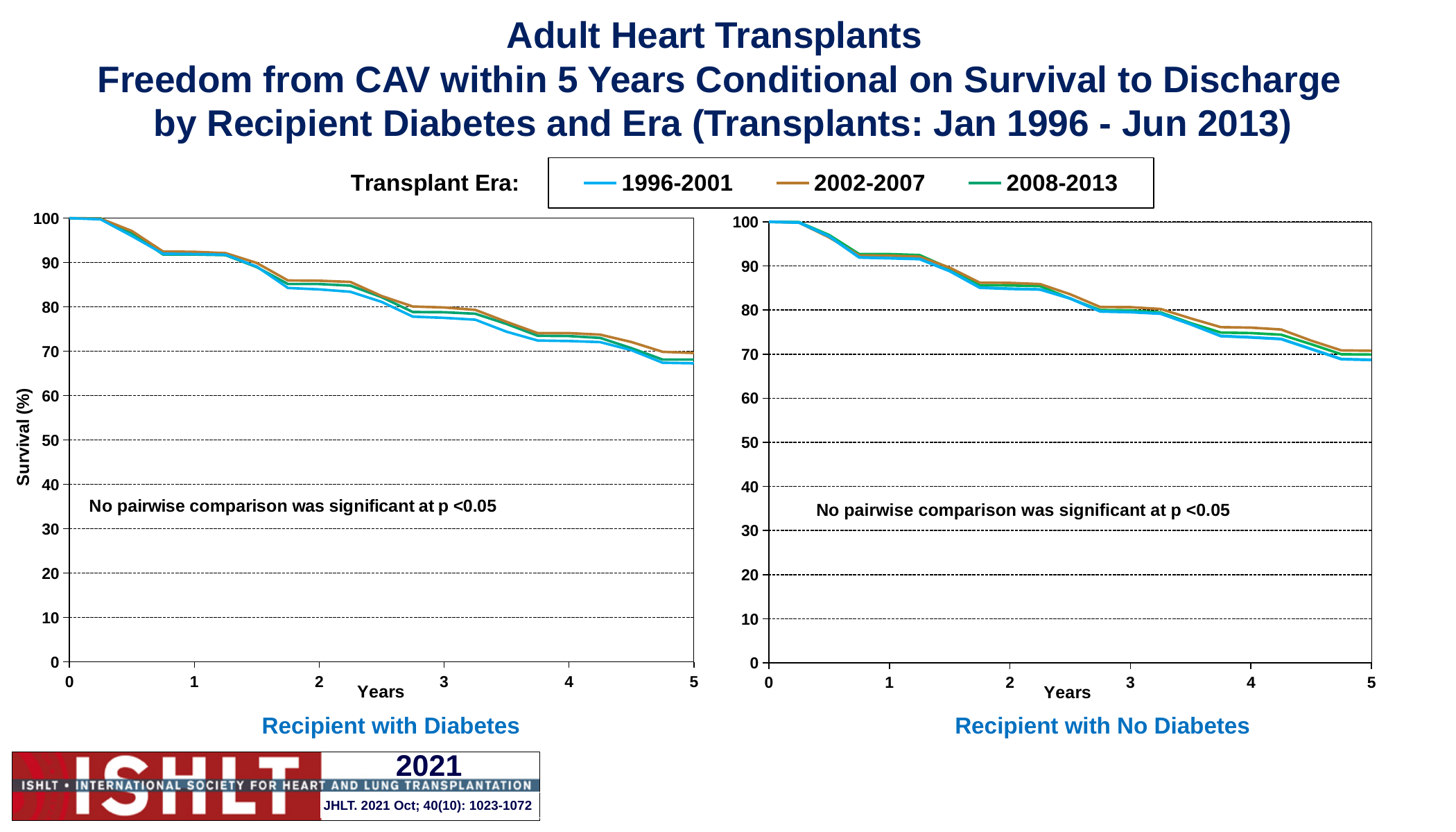
In the Recipient with No Diabetes chart, is the value for 2002-2007 at year 4 greater or less than 70? greater In the Recipient with Diabetes chart, is the value for 1996-2001 at year 5 greater or less than 70? less In the Recipient with Diabetes chart, what is the survival value for all eras at year 0? 100 What is the label on the y axis of the Recipient with Diabetes chart? Survival (%) In the Recipient with Diabetes chart, is the value for 1996-2001 at year 4 greater or less than 80? less In the Recipient with Diabetes chart, do the curves rise or fall as years increase? fall What kind of chart is shown for Recipient with Diabetes? line chart Which transplant era is drawn in brown in the legend? 2002-2007 How many transplant eras does the legend list? 3